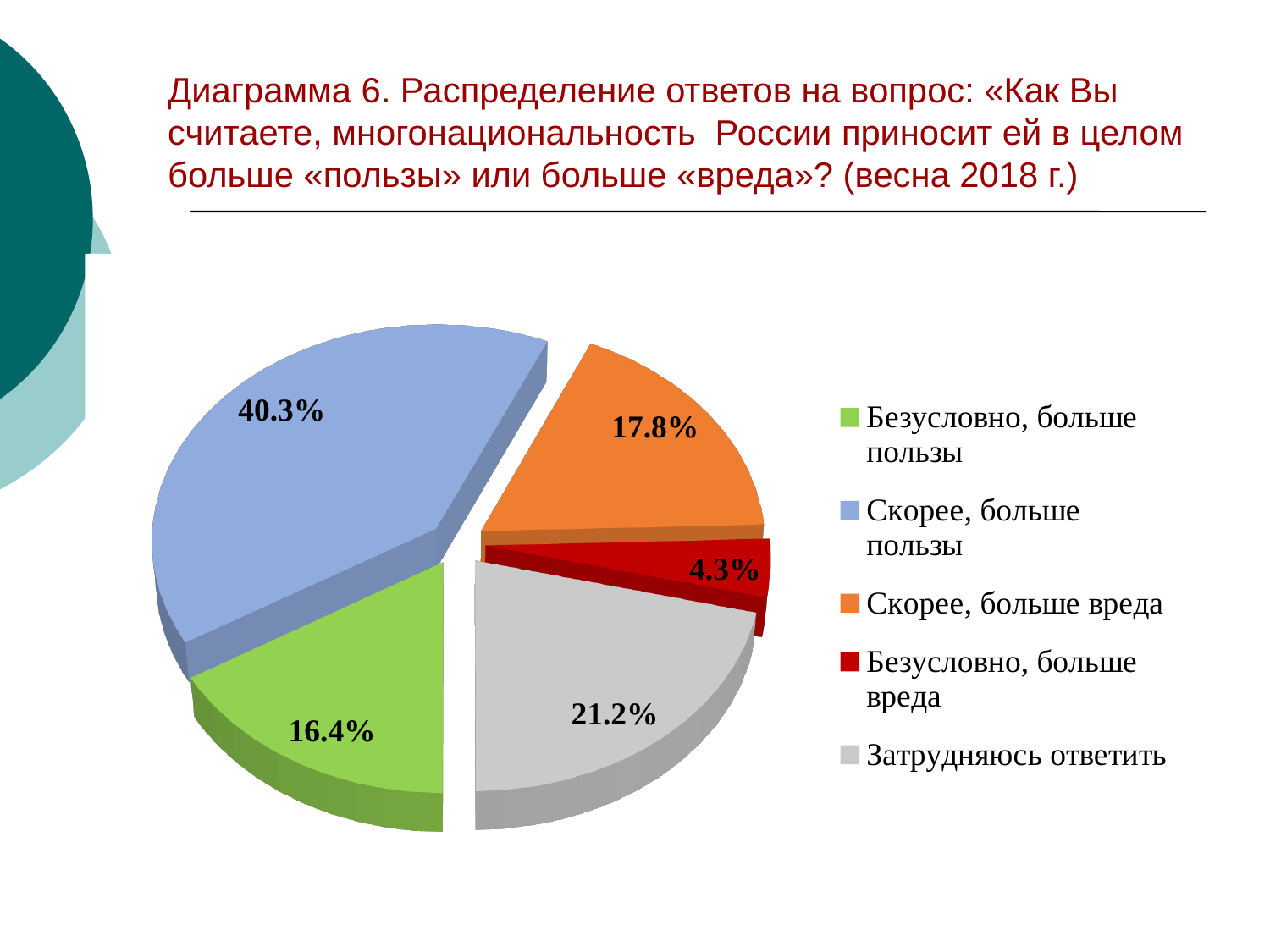
What share of respondents answered «Скорее, больше вреда»? 17.8% What kind of chart is shown on the slide? pie chart What is the difference between the shares for «Скорее, больше пользы» and «Затрудняюсь ответить»? 19.1% What share of respondents answered «Безусловно, больше вреда»? 4.3% Which answer option has the largest share? Скорее, больше пользы What colour is the slice for «Затрудняюсь ответить»? grey What share of respondents answered «Безусловно, больше пользы»? 16.4% What share of respondents answered «Скорее, больше пользы»? 40.3% What share of respondents answered «Затрудняюсь ответить»? 21.2% How many answer options does the legend list? 5 Which is larger: the share for «Скорее, больше вреда» or for «Безусловно, больше пользы»? Скорее, больше вреда Which answer option has the smallest share? Безусловно, больше вреда